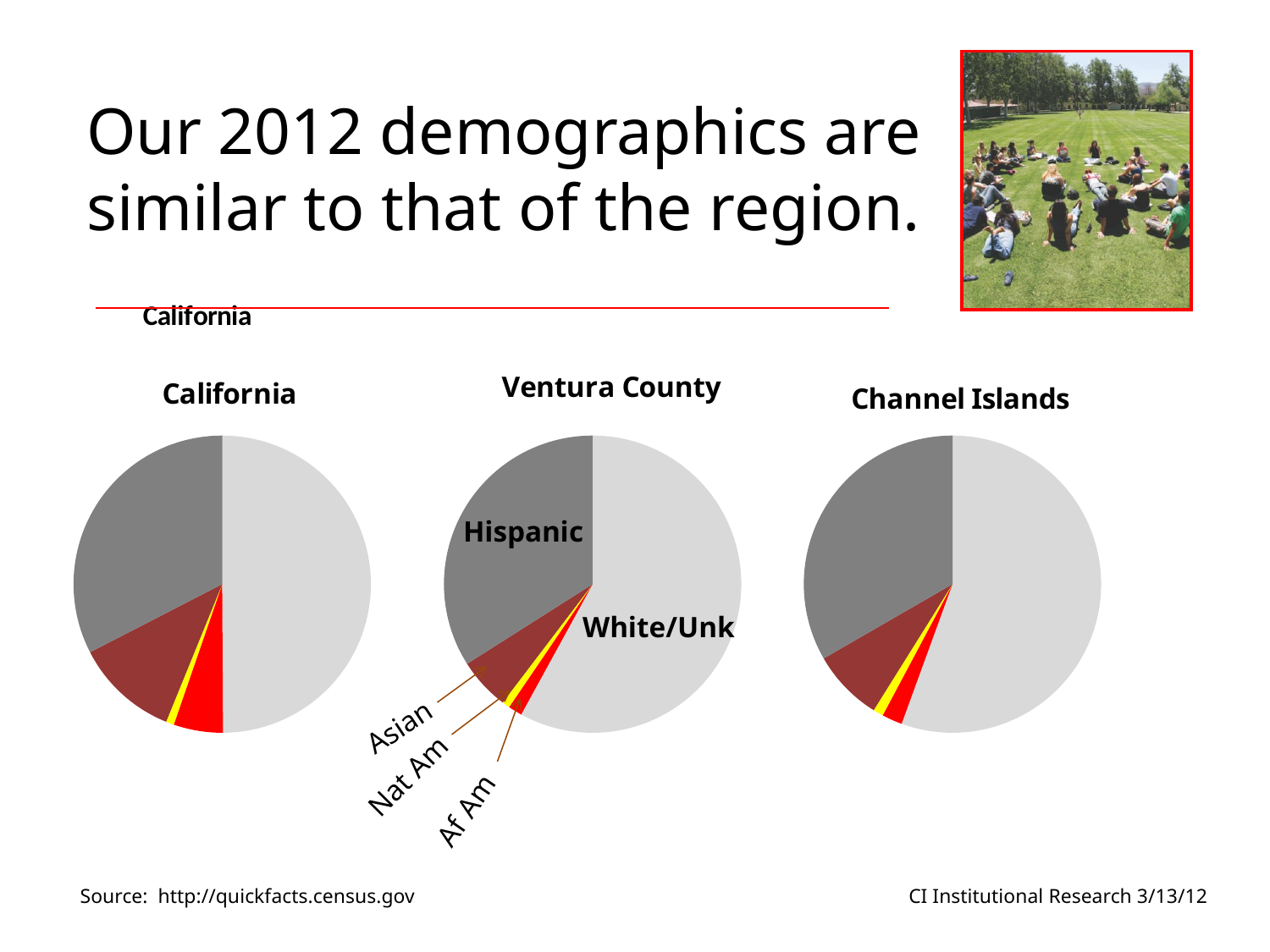
In the California pie chart, which category has the largest slice? White/Unk In the Channel Islands pie chart, which category has the largest slice? White/Unk In the California pie chart, which is larger, the Asian slice or the Af Am slice? Asian In the Ventura County pie chart, which category has the largest slice? White/Unk In the Ventura County pie chart, which category is shown in yellow? Nat Am What kind of chart is used for the California, Ventura County and Channel Islands demographics? Pie chart How many slices does the Ventura County pie chart have? 5 In the Ventura County pie chart, which is larger, the Hispanic slice or the White/Unk slice? White/Unk In the Ventura County pie chart, which is larger, the Hispanic slice or the Asian slice? Hispanic How many pie charts are shown on the slide? 3 What is the title of the middle pie chart? Ventura County In the California pie chart, which category has the smallest slice? Nat Am